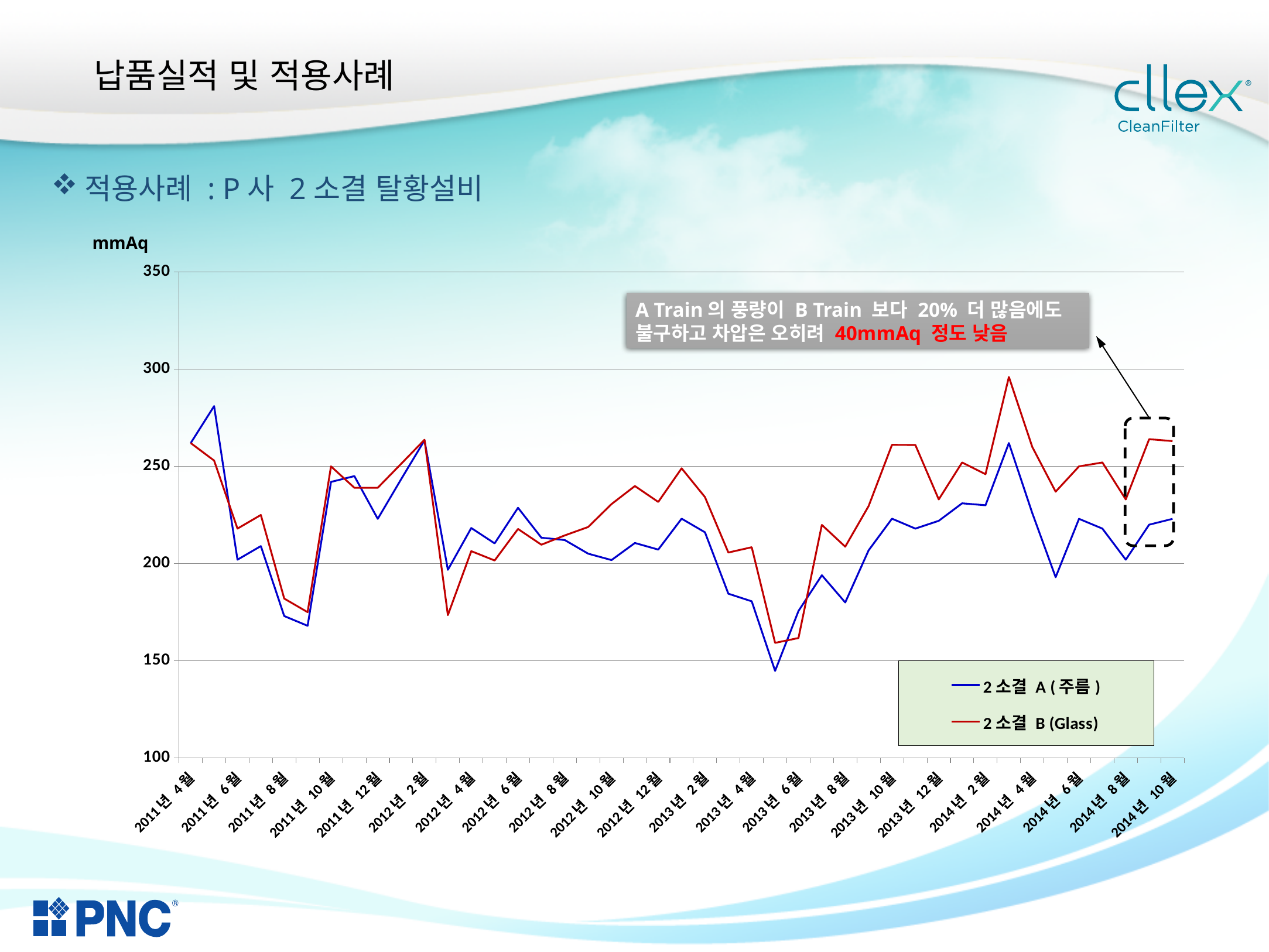
Is the value for 2 소결 A (주름) at 2011년 8월 greater or less than 200? less Which series is drawn in red according to the legend? 2 소결 B (Glass) What unit is shown on the y axis of the chart? mmAq How many series does the legend list? 2 What kind of chart is shown on the slide? line chart Which series reaches the highest value anywhere on the chart? 2 소결 B (Glass) Is the value for 2 소결 B (Glass) at 2014년 10월 greater or less than 250? greater At 2014년 10월, which series has the higher value, 2 소결 A (주름) or 2 소결 B (Glass)? 2 소결 B (Glass) Is the value for 2 소결 B (Glass) at 2014년 4월 greater or less than 300? less At 2013년 10월, which series has the higher value, 2 소결 A (주름) or 2 소결 B (Glass)? 2 소결 B (Glass)